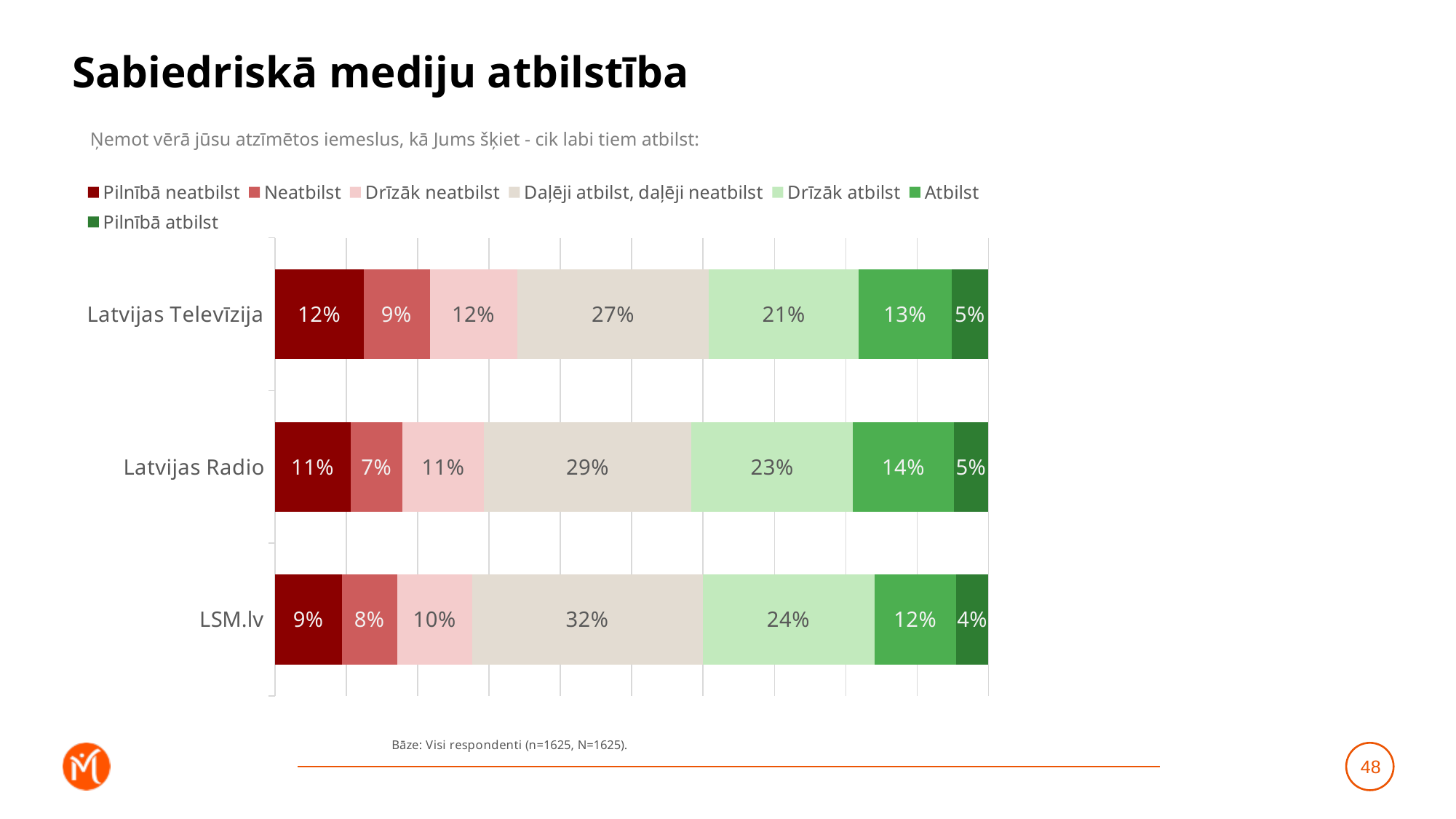
What is the value for "Daļēji atbilst, daļēji neatbilst" for Latvijas Televīzija? 27% What is the total of the stacked bar for Latvijas Radio? 100% What is the value for "Pilnībā neatbilst" for Latvijas Radio? 11% Which category has the highest value for "Daļēji atbilst, daļēji neatbilst"? LSM.lv What kind of chart is shown on the slide? Stacked bar chart How many categories are shown on the y axis? 3 What is the value for "Drīzāk atbilst" for LSM.lv? 24% What is the value for "Atbilst" for Latvijas Radio? 14% Which is larger: the "Neatbilst" value for Latvijas Televīzija or for Latvijas Radio? Latvijas Televīzija What is the difference between the "Drīzāk atbilst" values for LSM.lv and Latvijas Televīzija? 3% How many series does the legend list? 7 Which category has the lowest value for "Pilnībā neatbilst"? LSM.lv